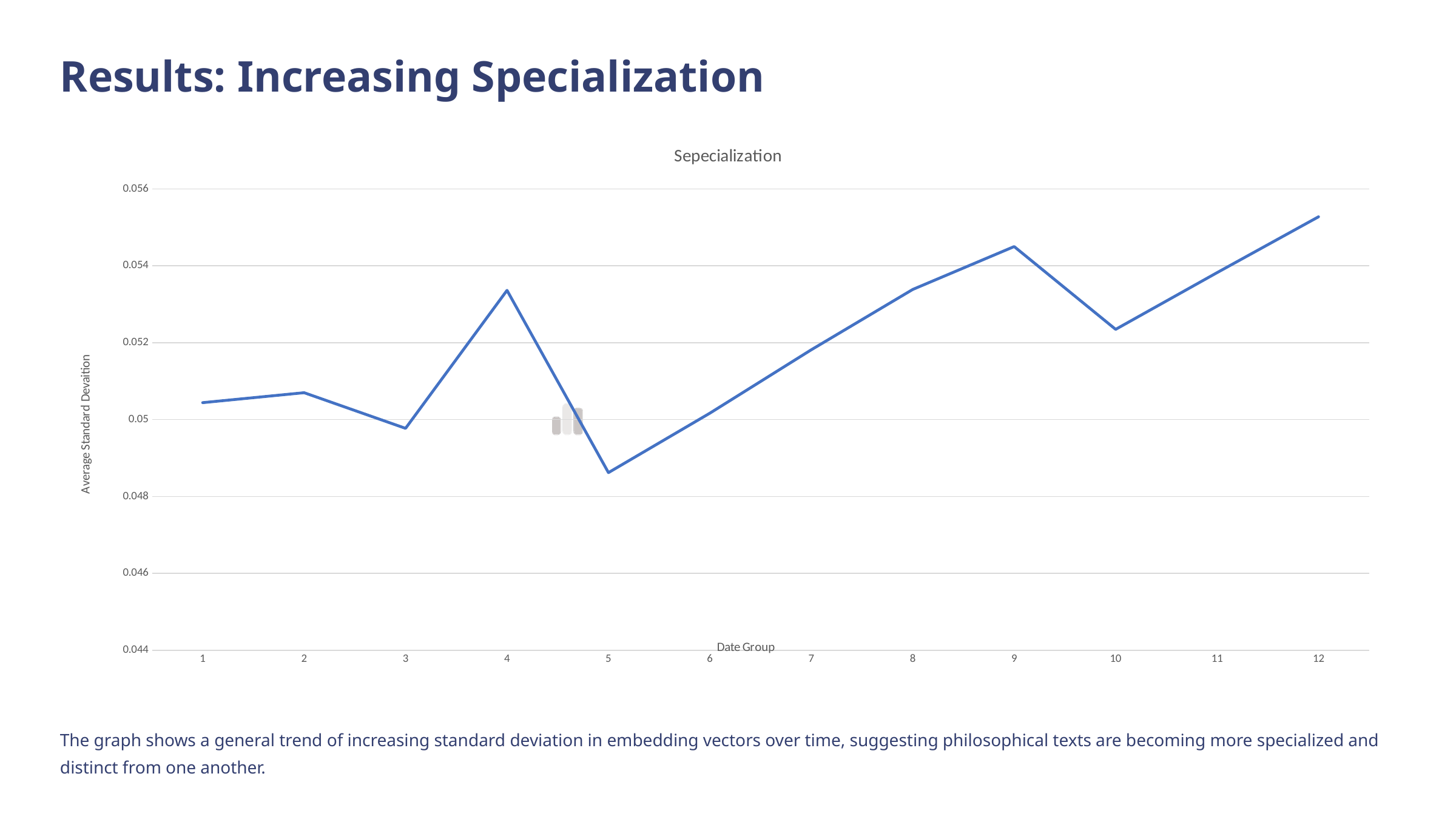
Is the value for Date Group 8 greater or less than 0.052? greater Is the value for Date Group 5 greater or less than 0.05? less How many Date Groups are plotted on the x axis? 12 Overall, do the values rise or fall from Date Group 1 to Date Group 12? Rise What kind of chart is shown on the slide? Line chart What is the label on the vertical axis of the chart? Average Standard Devaition Which Date Group has the lowest Average Standard Deviation? 5 Is the value for Date Group 4 greater or less than 0.052? greater Which has the larger value, Date Group 9 or Date Group 10? Date Group 9 Which Date Group has the highest Average Standard Deviation? 12 Which has the larger value, Date Group 4 or Date Group 5? Date Group 4